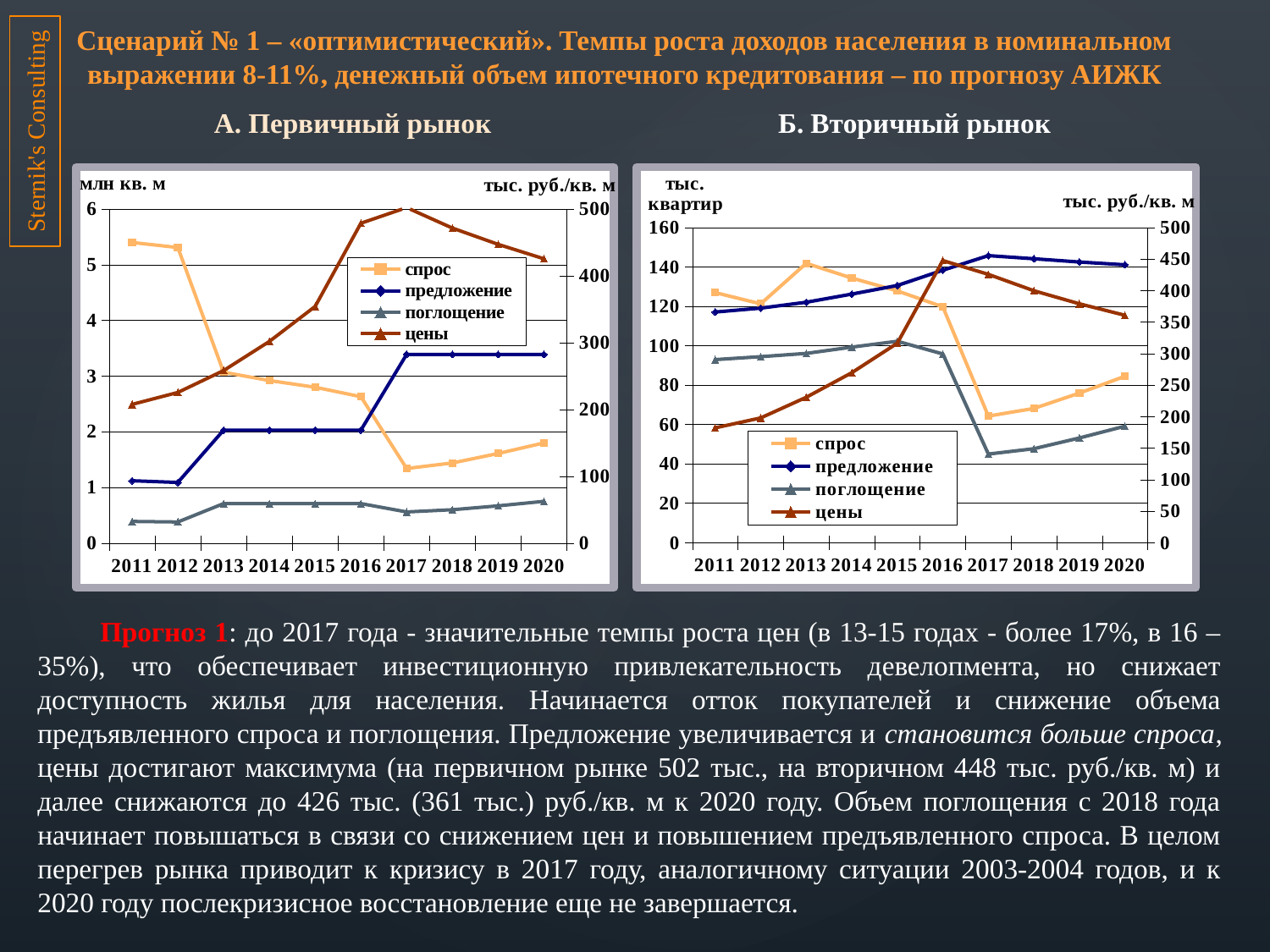
In the «А. Первичный рынок» chart, does спрос rise or fall from 2011 to 2017? fall In the «А. Первичный рынок» chart, is the value for предложение in 2020 greater or less than 3? greater In the «А. Первичный рынок» chart, is the value for спрос in 2011 greater or less than 5? greater In the «А. Первичный рынок» chart, in which year does the цены series reach its highest value? 2017 In the «Б. Вторичный рынок» chart, in which year is поглощение lowest? 2017 In the «Б. Вторичный рынок» chart, in which year is спрос highest? 2013 How many years are shown on the x axis of the «А. Первичный рынок» chart? 10 In the «Б. Вторичный рынок» chart, does предложение rise or fall from 2011 to 2017? rise In the «Б. Вторичный рынок» chart, which is larger in 2017: спрос or предложение? предложение How many series does the legend of the «Б. Вторичный рынок» chart list? 4 What kind of chart is used for «А. Первичный рынок»? line chart In the «Б. Вторичный рынок» chart, is the value for цены in 2016 greater or less than 400? greater